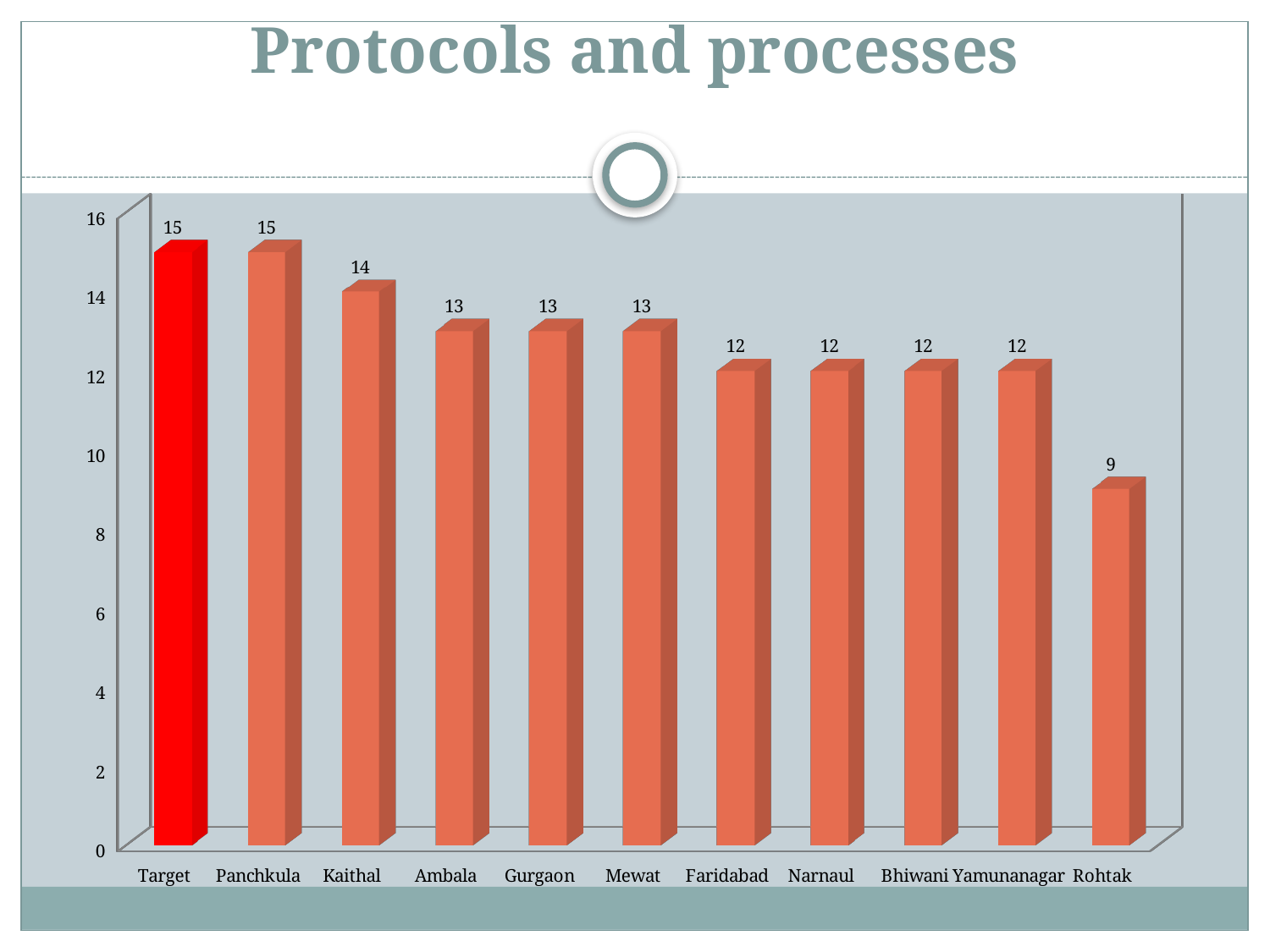
What is the difference between the values for Panchkula and Rohtak? 6 Which category has the lowest value? Rohtak What is the difference between the values for Kaithal and Ambala? 1 What is the value for Kaithal? 14 Do the values generally rise or fall from left to right along the x axis? fall What is the title of the slide? Protocols and processes What is the value for Rohtak? 9 How many categories are shown on the x axis? 11 What kind of chart is shown on the slide? bar chart What is the value for Faridabad? 12 Which is larger, the value for Mewat or the value for Narnaul? Mewat What is the value for Target? 15